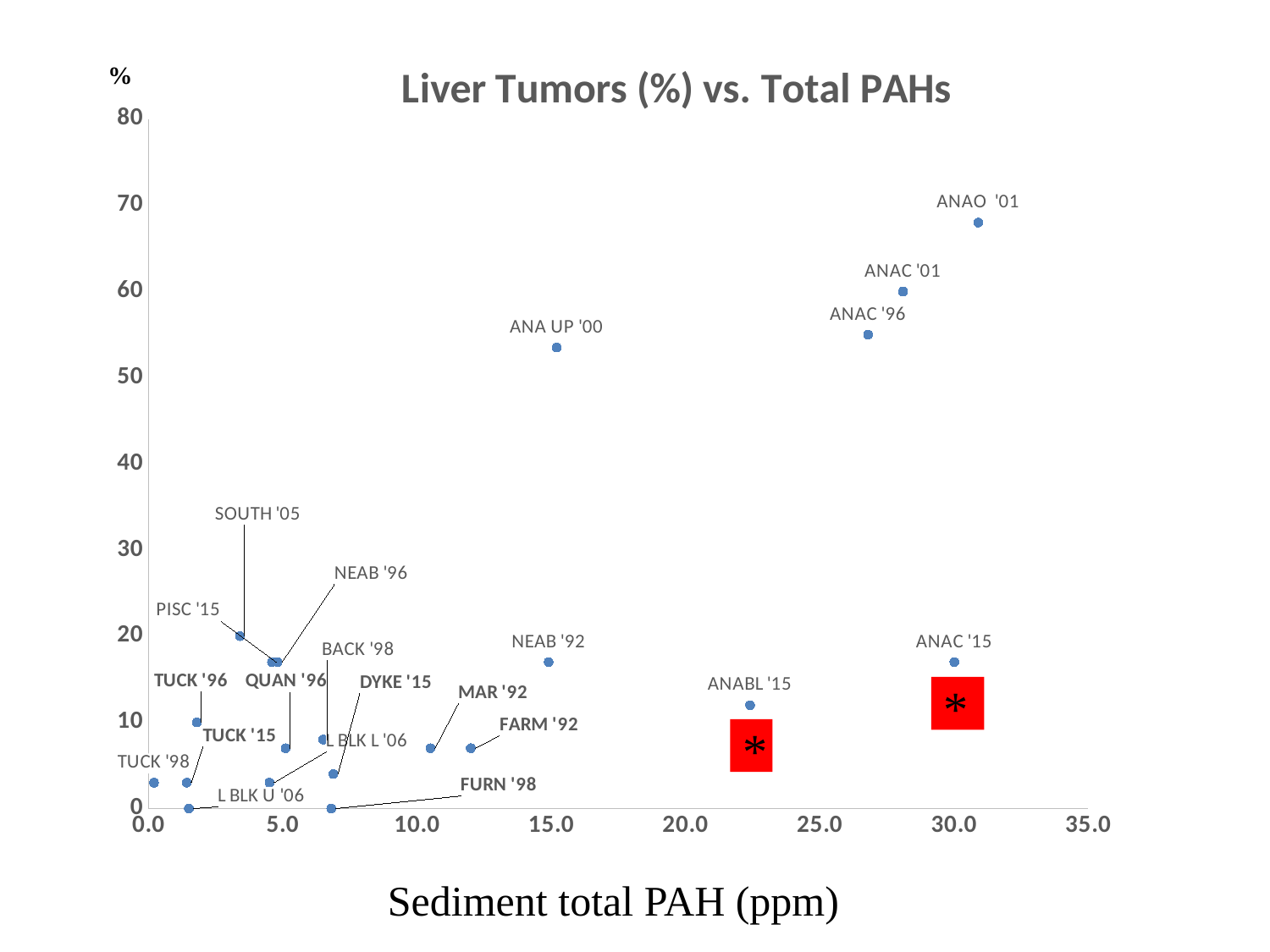
Is the liver tumor value for ANA UP '00 greater or less than 50? greater Is the liver tumor value for ANABL '15 greater or less than 10? greater Which labeled point has the highest liver tumor percentage? ANAO '01 What is the title of the chart? Liver Tumors (%) vs. Total PAHs Is the liver tumor value for NEAB '92 greater or less than 20? less Which has a higher liver tumor percentage, ANA UP '00 or NEAB '92? ANA UP '00 What kind of chart is shown on the slide? scatter chart Which has a higher liver tumor percentage, ANAO '01 or ANAC '15? ANAO '01 What is the label of the x axis? Sediment total PAH (ppm)